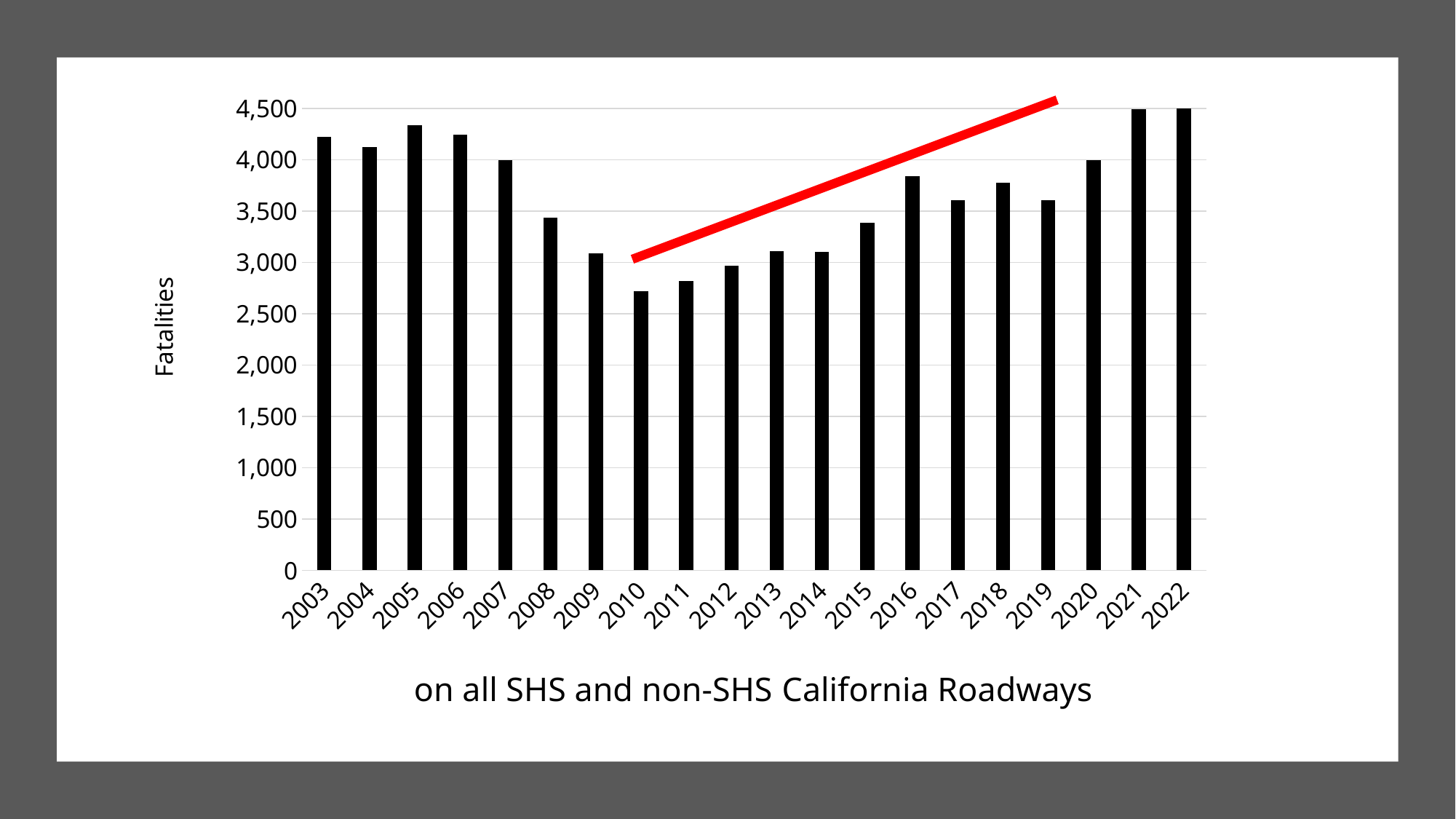
Is the value for 2010 greater or less than 3,000? less How many years (bars) are plotted on the chart? 20 Is the value for 2015 greater or less than 3,500? less What kind of chart is shown on the slide? bar chart Which year has more fatalities, 2005 or 2008? 2005 Which year has the lowest number of fatalities? 2010 What is the label on the vertical axis? Fatalities What colour is the diagonal line drawn over the bars? red Is the value for 2005 greater or less than 4,000? greater Do the fatalities rise or fall from 2010 to 2016? rise